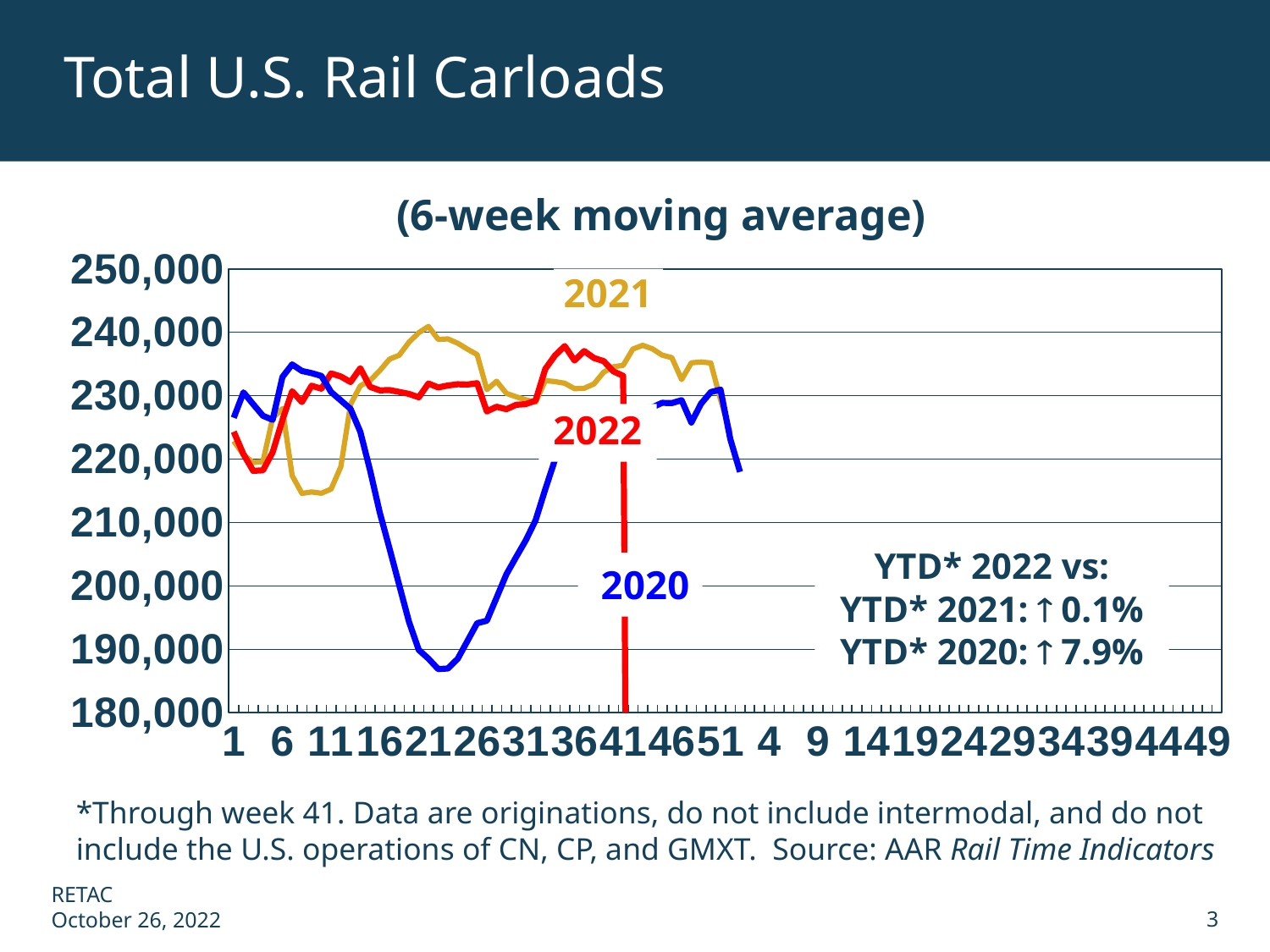
According to the text on the chart, by how much is YTD 2022 up versus YTD 2020? 7.9% Does the 2020 line rise or fall between week 26 and week 36? rise Is the value of the 2021 line at week 11 greater or less than 220,000? less How many data series (years) are plotted on the chart? 3 Is the value of the 2020 line at week 6 greater or less than 230,000? greater Does the 2020 line rise or fall between week 11 and week 21? fall At week 21, which line is higher, 2021 or 2020? 2021 Is the value of the 2022 line at week 36 greater or less than 230,000? greater According to the text on the chart, by how much is YTD 2022 up versus YTD 2021? 0.1% Which year's line dips to the lowest value on the chart? 2020 What kind of chart is shown on the slide? line chart